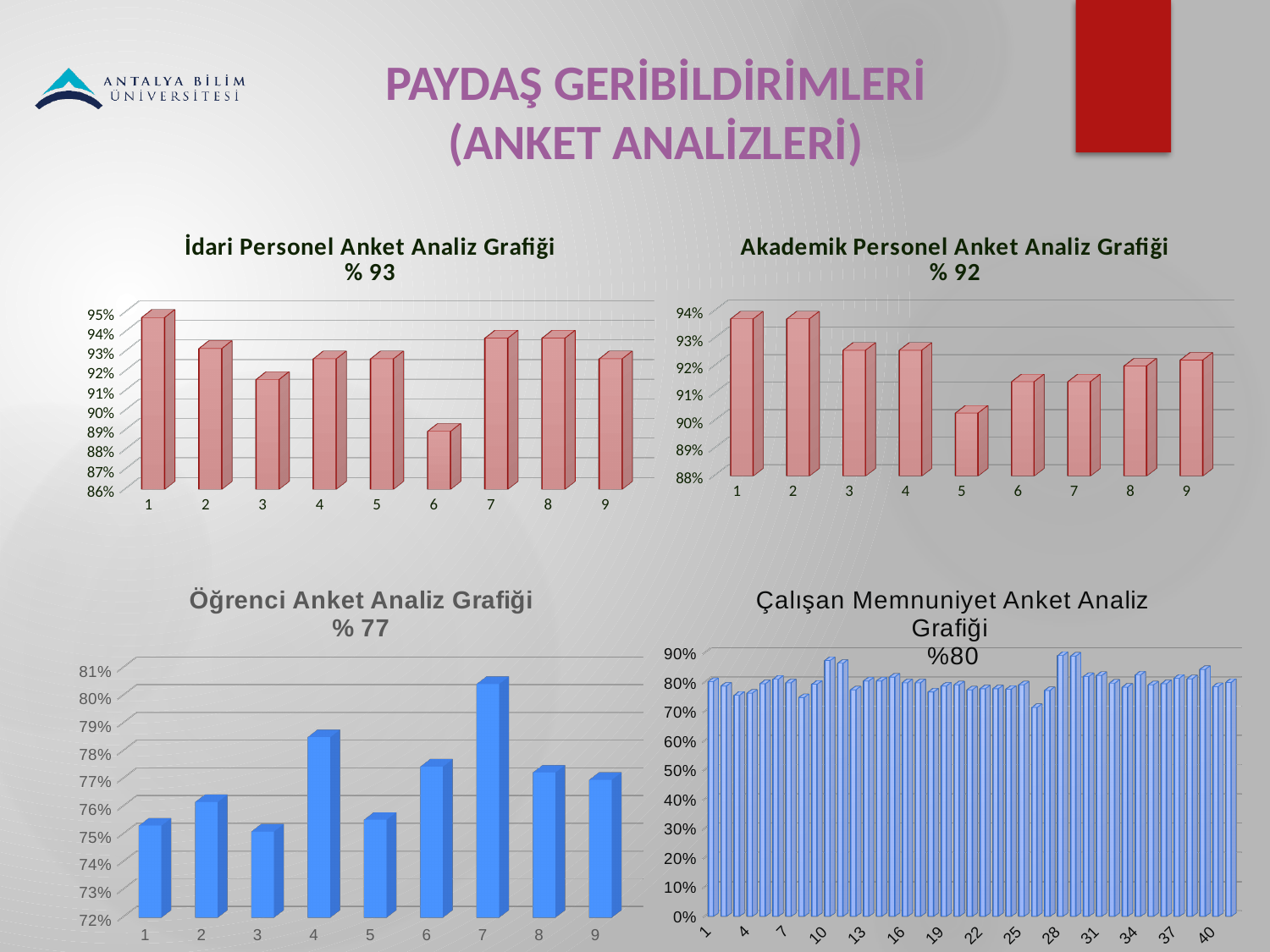
In the 'Öğrenci Anket Analiz Grafiği' chart, which category has the highest value? 7 In the 'İdari Personel Anket Analiz Grafiği' chart, which category has the lowest value? 6 In the 'İdari Personel Anket Analiz Grafiği' chart, how many categories are plotted? 9 In the 'Akademik Personel Anket Analiz Grafiği' chart, is the value for category 1 greater or less than 93%? greater What kind of chart is the 'Çalışan Memnuniyet Anket Analiz Grafiği' chart? bar chart What overall percentage is shown in the title of the 'Öğrenci Anket Analiz Grafiği' chart? % 77 In the 'Akademik Personel Anket Analiz Grafiği' chart, which category has the lowest value? 5 In the 'Akademik Personel Anket Analiz Grafiği' chart, which is larger, the value for category 3 or category 6? category 3 In the 'İdari Personel Anket Analiz Grafiği' chart, is the value for category 6 greater or less than 90%? less In the 'Öğrenci Anket Analiz Grafiği' chart, which is larger, the value for category 2 or category 4? category 4 In the 'Öğrenci Anket Analiz Grafiği' chart, is the value for category 4 greater or less than 78%? greater In the 'İdari Personel Anket Analiz Grafiği' chart, which category has the highest value? 1